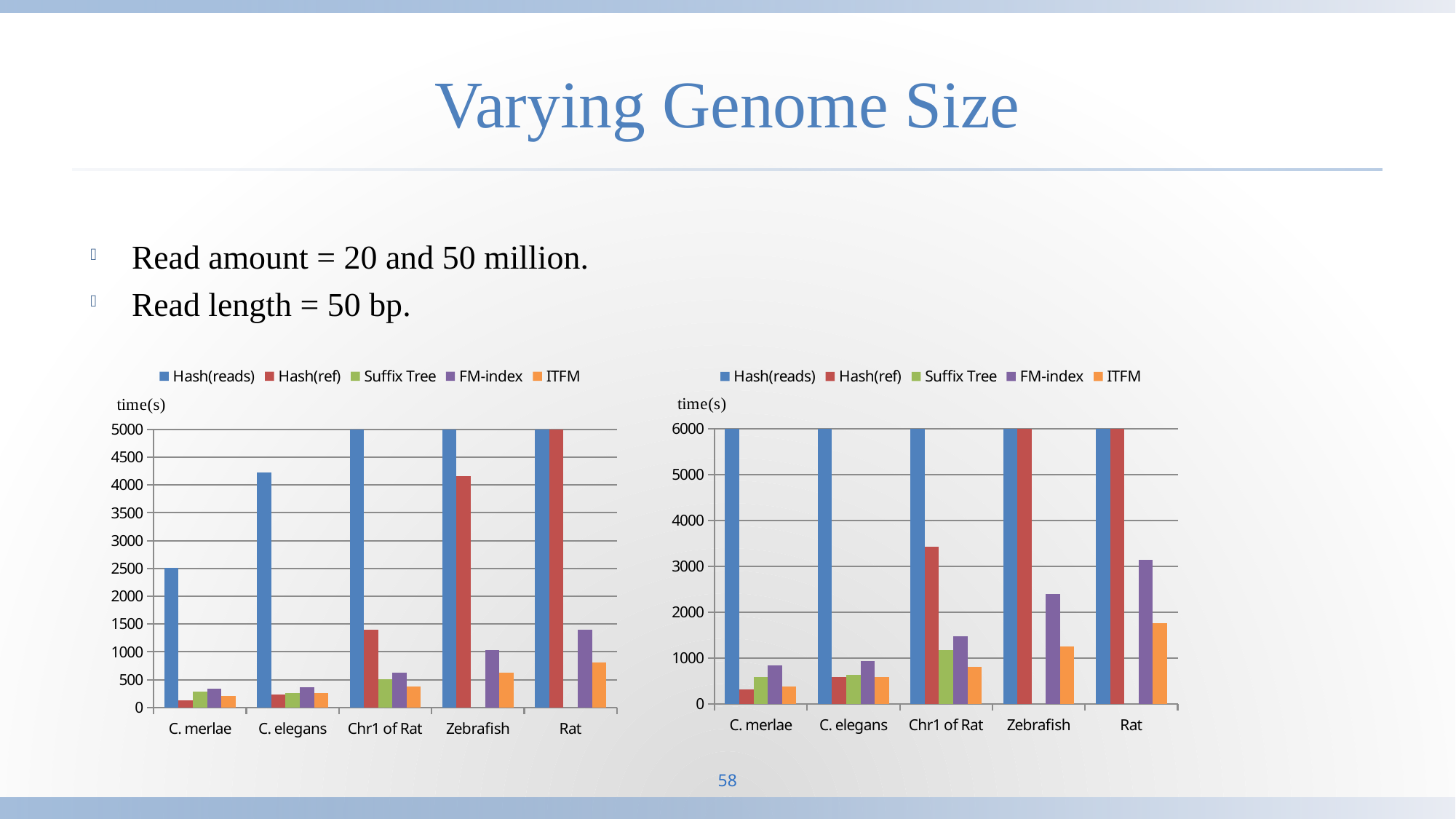
What is the label on the vertical axis of the left chart? time(s) How many series does the legend of the right chart list? 5 In the left chart, is the Hash(ref) value for Chr1 of Rat greater or less than 1000? greater In the right chart, is the Hash(ref) value for Chr1 of Rat greater or less than 3000? greater How many categories are shown on the x axis of the left chart? 5 In the right chart, which is larger for Zebrafish: FM-index or ITFM? FM-index In the left chart, is the Hash(reads) value for C. elegans greater or less than 4000? greater In the left chart, which series has the lowest value for C. merlae? Hash(ref) What kind of chart is the left chart on the slide? bar chart In the right chart, do the ITFM values rise or fall from C. merlae to Rat? rise Which series is shown in orange in the legend of the right chart? ITFM